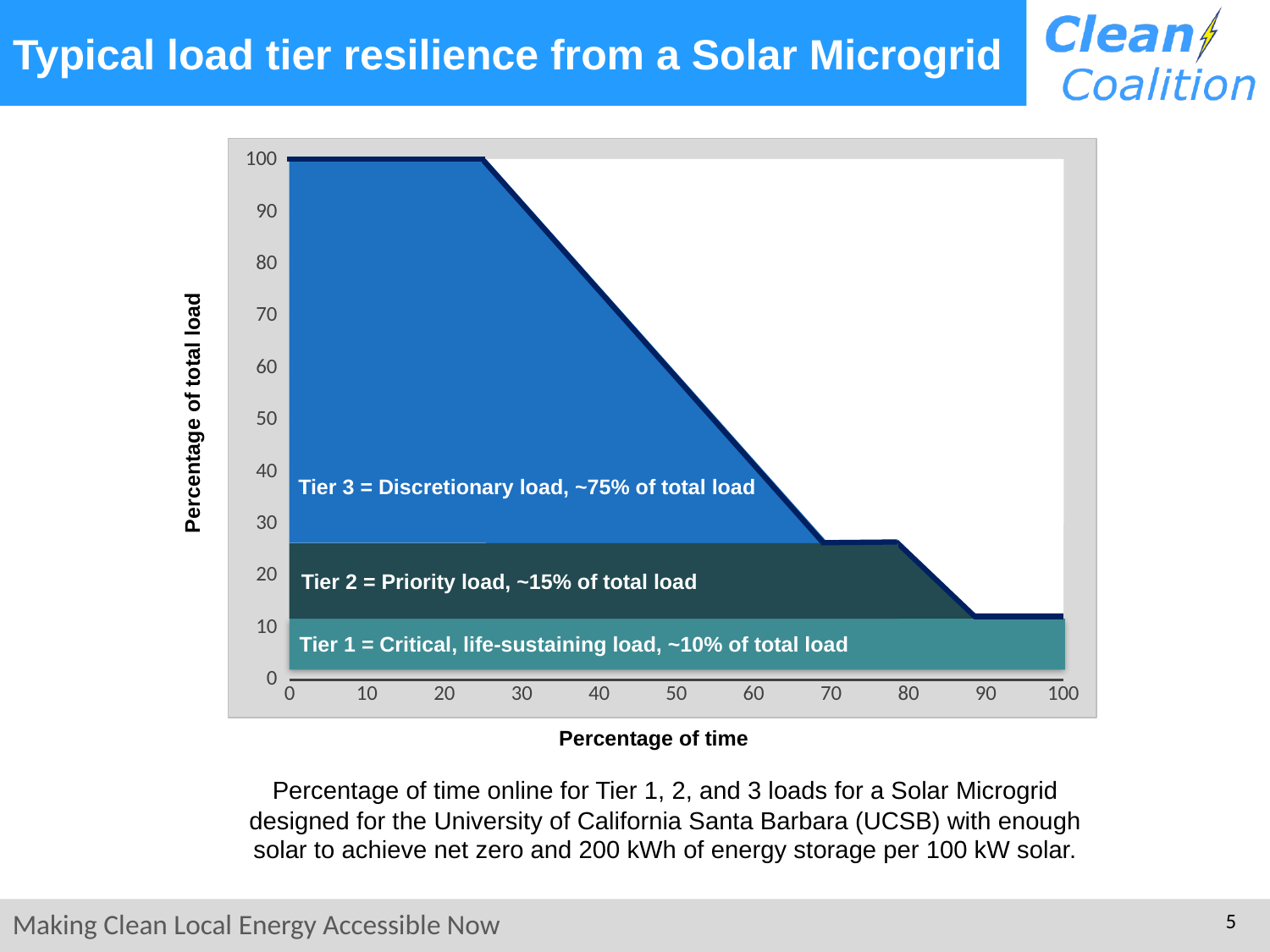
Is the percentage of total load at 50 percent of time greater or less than 50? greater Does the plotted percentage of total load rise or fall as the percentage of time increases? fall Which is larger, the percentage of total load at 20 percent of time or at 80 percent of time? 20 percent of time How many load tiers are labelled on the chart? 3 Is the percentage of total load at 90 percent of time greater or less than 20? less What is the title of the chart's y axis? Percentage of total load What is the percentage of total load at 10 percent of time? 100 What is the title of the chart's x axis? Percentage of time What is the percentage of total load at 0 percent of time? 100 Is the percentage of total load at 40 percent of time greater or less than 60? greater What kind of chart is shown on the slide? area chart